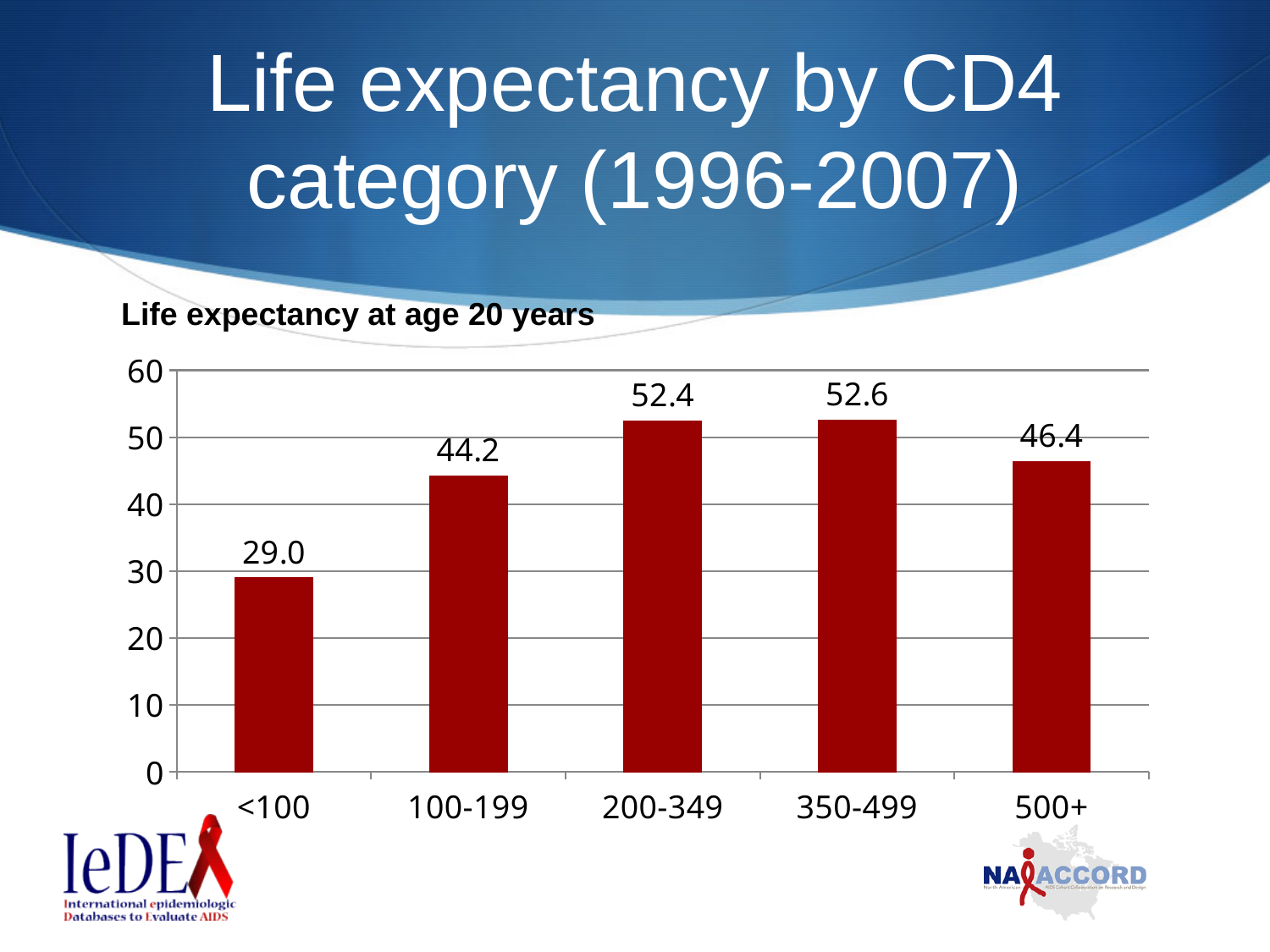
What is the life expectancy at age 20 for the <100 CD4 category? 29.0 What is the life expectancy at age 20 for the 500+ CD4 category? 46.4 What is the life expectancy at age 20 for the 100-199 CD4 category? 44.2 What type of chart is used to show life expectancy by CD4 category? bar chart What is the difference in life expectancy between the 100-199 and <100 CD4 categories? 15.2 Is the life expectancy for the <100 CD4 category greater or less than 30? less Which has a higher life expectancy at age 20: the 100-199 or the 500+ CD4 category? 500+ How many CD4 categories are shown in the chart? 5 What is the life expectancy at age 20 for the 200-349 CD4 category? 52.4 What is the difference in life expectancy between the 350-499 and <100 CD4 categories? 23.6 Which CD4 category has the lowest life expectancy at age 20? <100 Which CD4 category has the highest life expectancy at age 20? 350-499